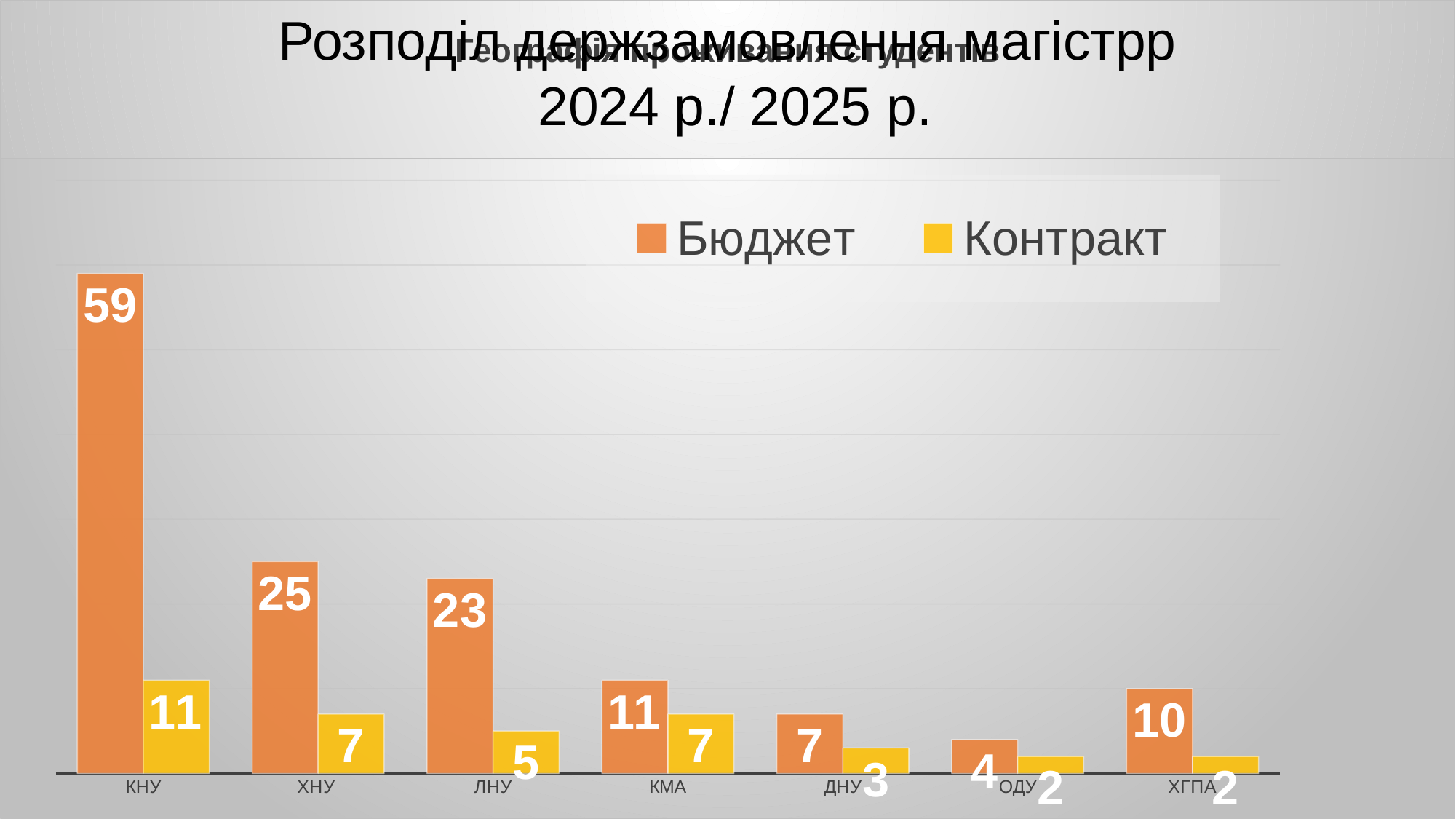
What is the Бюджет value for ХГПА? 10 What is the Бюджет value for КНУ? 59 What kind of chart is shown on the slide? bar chart What is the Контракт value for ХНУ? 7 Which category has the highest Бюджет value? КНУ Which category has the lowest Бюджет value? ОДУ How many categories are shown on the x axis? 7 Which series is shown in yellow in the legend? Контракт How many series does the legend list? 2 What is the difference between the Бюджет values for ХНУ and ЛНУ? 2 Which is larger, the Бюджет value for КМА or the Бюджет value for ХГПА? КМА What is the difference between the Бюджет and Контракт values for ЛНУ? 18